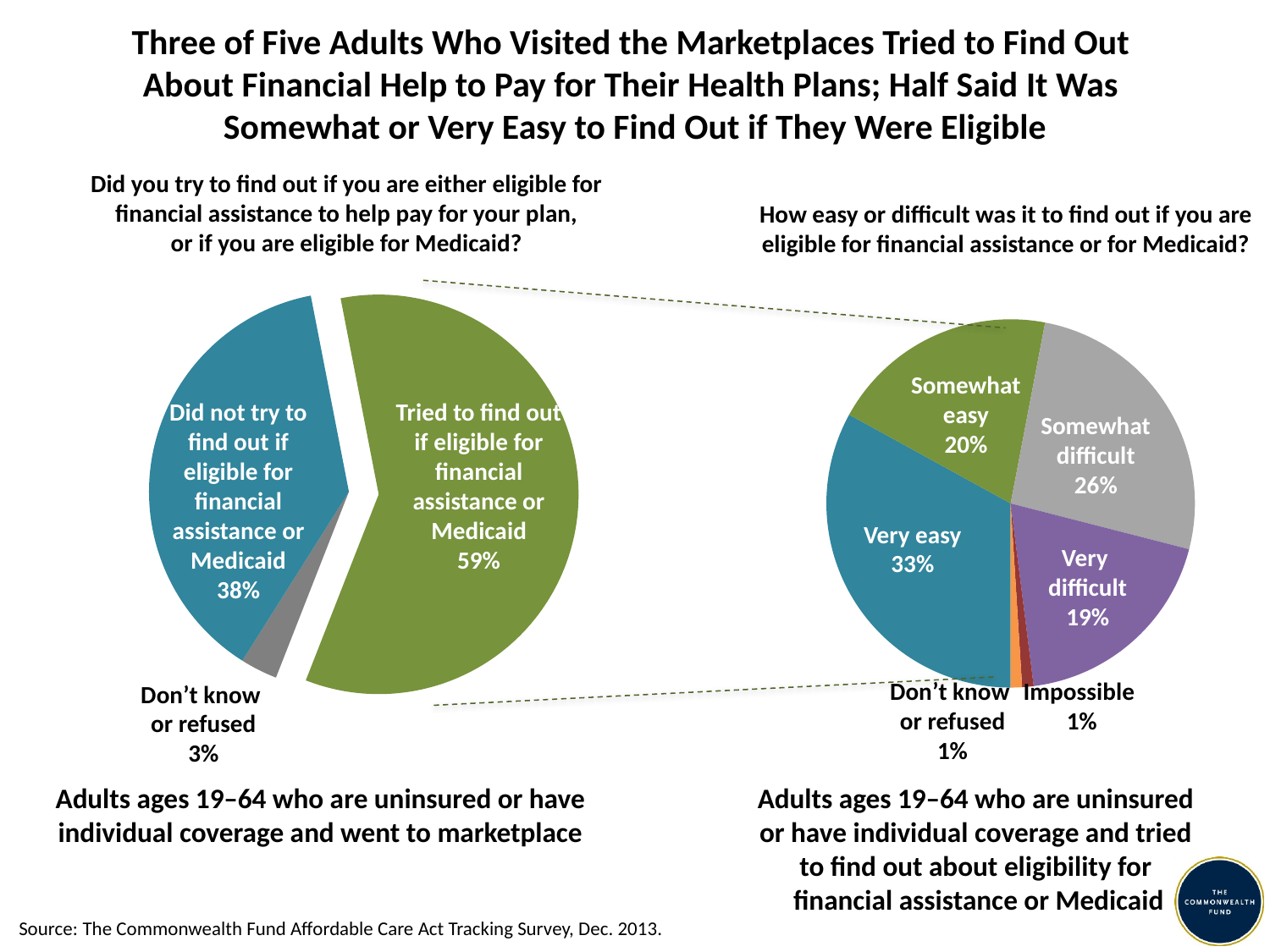
How many slices does the right pie chart have? 6 What type of chart is used on the left side of the slide? Pie chart In the left pie chart, what share of adults did not try to find out if eligible for financial assistance or Medicaid? 38% In the right pie chart, what share said it was somewhat difficult? 26% In the left pie chart, what share answered 'Don't know or refused'? 3% In the right pie chart, what share said it was impossible? 1% In the right pie chart, which is larger: 'Somewhat easy' or 'Somewhat difficult'? Somewhat difficult In the left pie chart, which category has the smallest share? Don't know or refused In the right pie chart, what share said it was very easy to find out if they were eligible? 33% In the right pie chart, what is the difference between the 'Somewhat difficult' and 'Very difficult' shares? 7 percentage points In the left pie chart, what share of adults tried to find out if eligible for financial assistance or Medicaid? 59% In the right pie chart, which response has the largest share? Very easy